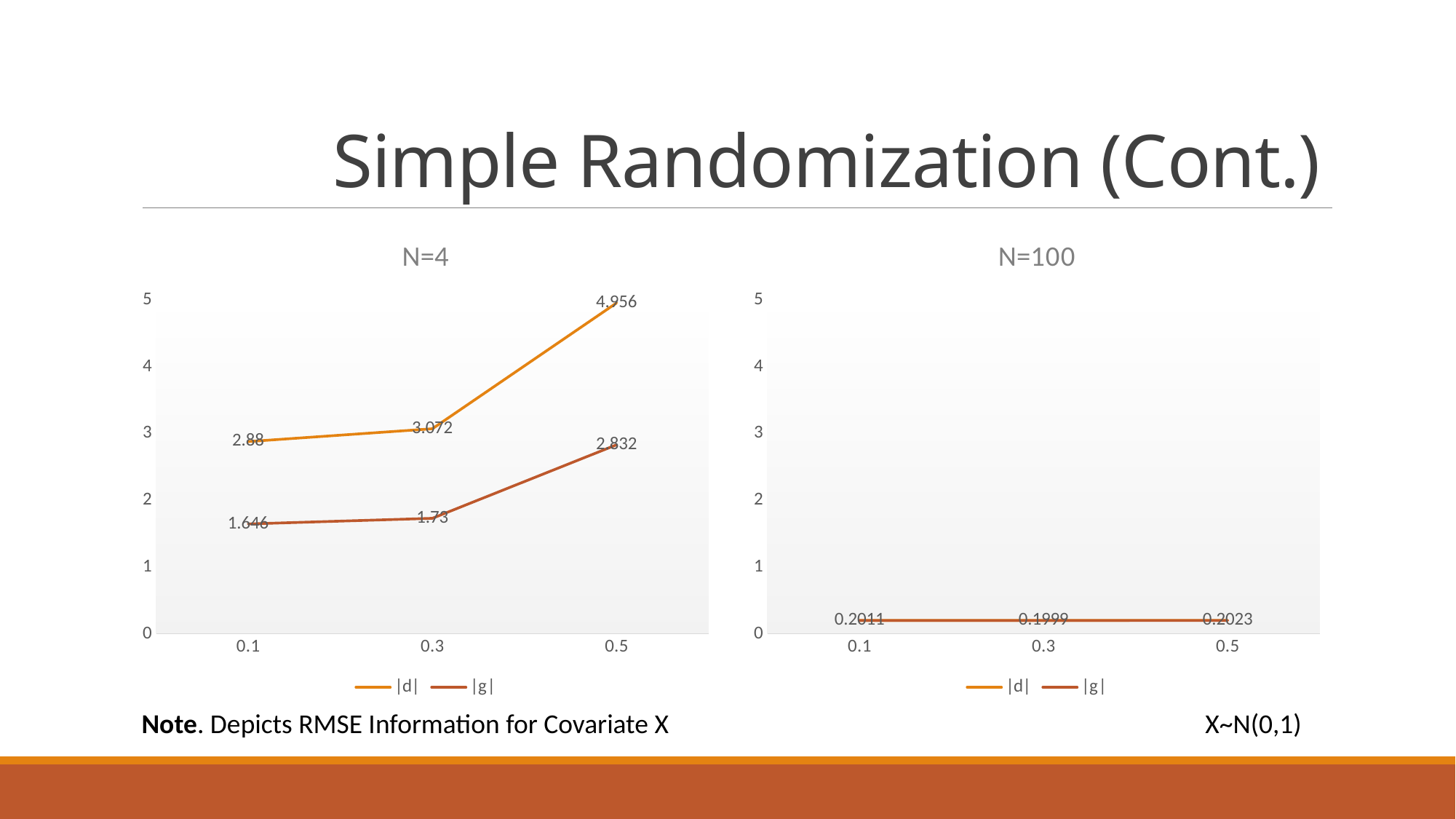
In the N=4 chart, what is the value of |d| at 0.3? 3.072 How many x-axis points are plotted in the N=100 chart? 3 In the N=100 chart, is the value for |d| at 0.5 greater or less than 1? less In the N=4 chart, does |d| rise or fall as x increases from 0.1 to 0.5? rise In the N=4 chart, what is the value of |g| at 0.1? 1.646 In the N=4 chart, what is the difference between |d| and |g| at 0.5? 2.124 How many series does the legend of the N=4 chart list? 2 In the N=4 chart, at which x value is |d| lowest? 0.1 In the N=4 chart, what is the value of |d| at 0.5? 4.956 What kind of chart is the N=100 chart? line chart In the N=4 chart, which series is larger at 0.3, |d| or |g|? |d| In the N=4 chart, at which x value is |g| highest? 0.5